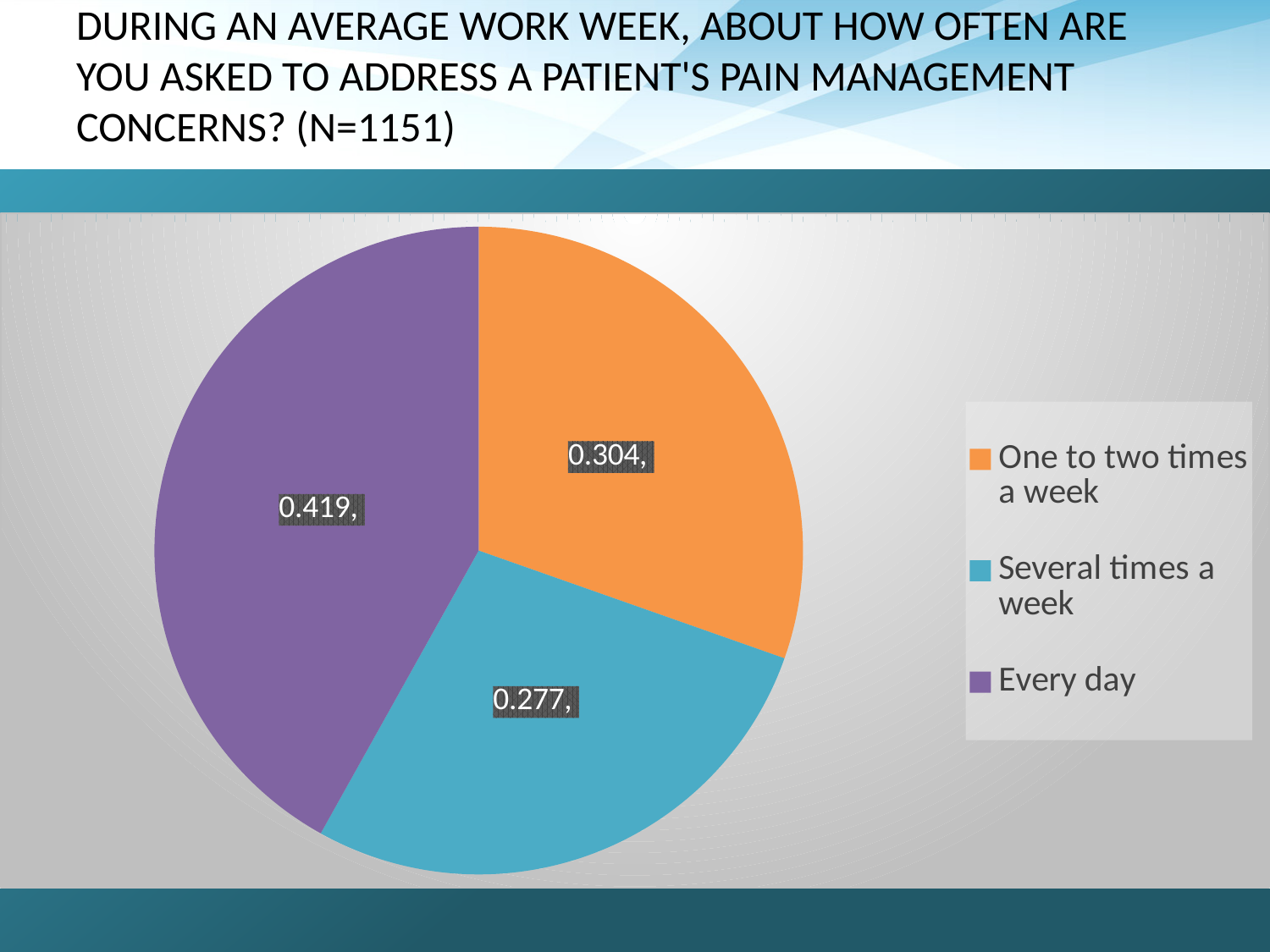
What is the difference between the values for "Every day" and "One to two times a week"? 0.115 What is the value for "Several times a week"? 0.277 What kind of chart is shown on the slide? pie chart What is the sample size (N) given in the slide title? 1151 Which category has the smallest slice? Several times a week Which category has the largest slice? Every day How many slices does the pie chart have? 3 What is the difference between the values for "One to two times a week" and "Several times a week"? 0.027 What is the value for "One to two times a week"? 0.304 Which colour represents "Several times a week" in the legend? blue Which is larger, the value for "Every day" or the value for "Several times a week"? Every day What is the value for "Every day"? 0.419